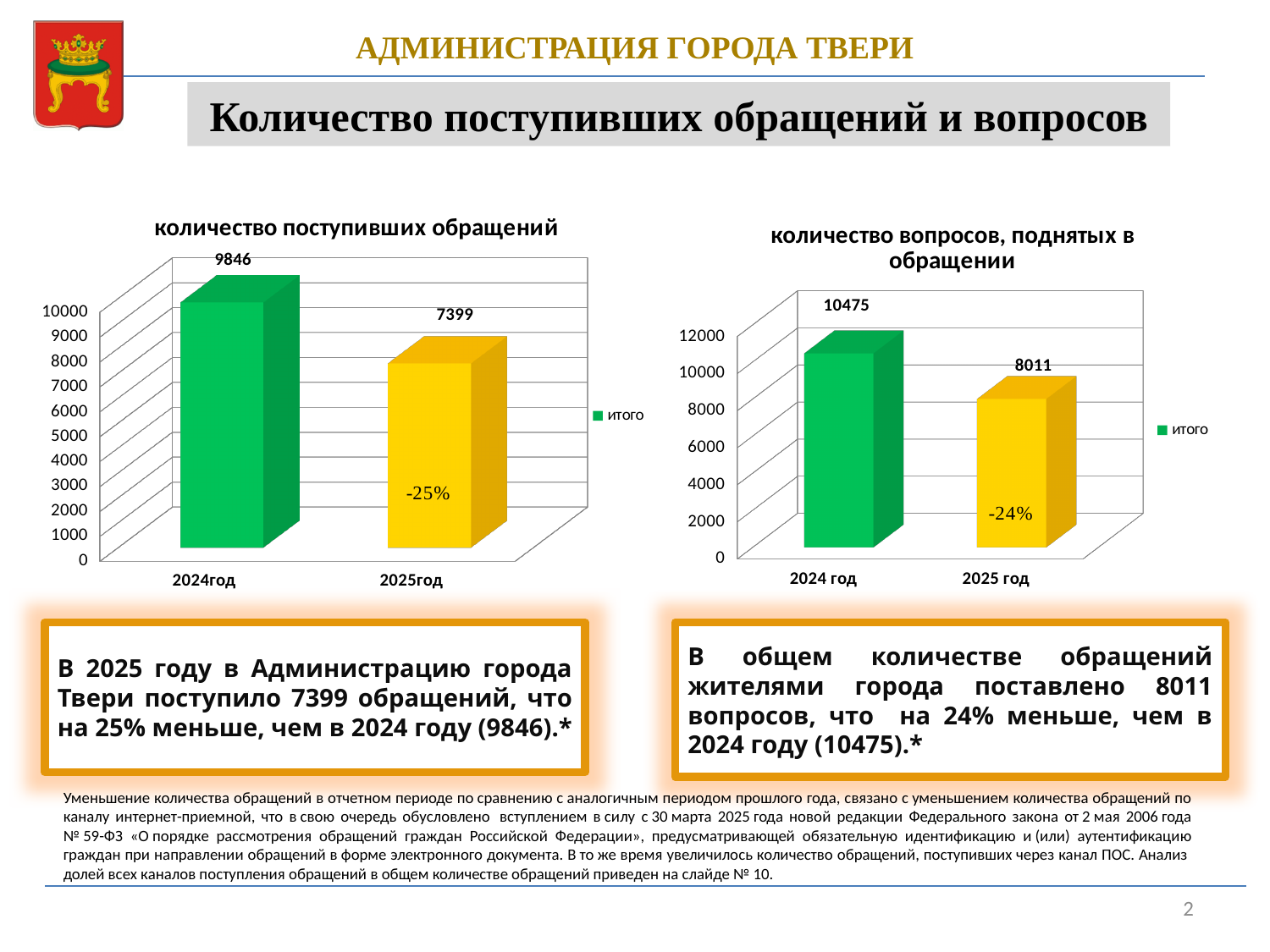
In the left chart, what is the difference between the 2024год and 2025год values? 2447 In the chart titled "количество вопросов, поднятых в обращении", what is the value for 2025 год? 8011 In the chart titled "количество поступивших обращений", what is the value for 2024год? 9846 What type of chart is the chart titled "количество вопросов, поднятых в обращении"? bar chart How many categories are shown in the left chart? 2 In the right chart, is the value for 2025 год greater or less than 10000? less In the right chart, what is the difference between the 2024 год and 2025 год values? 2464 In the chart titled "количество поступивших обращений", what is the value for 2025год? 7399 In the left chart, which year has the higher value? 2024год What series name does the legend of the left chart show? итого In the chart titled "количество вопросов, поднятых в обращении", what is the value for 2024 год? 10475 In the right chart, which year has the lower value? 2025 год